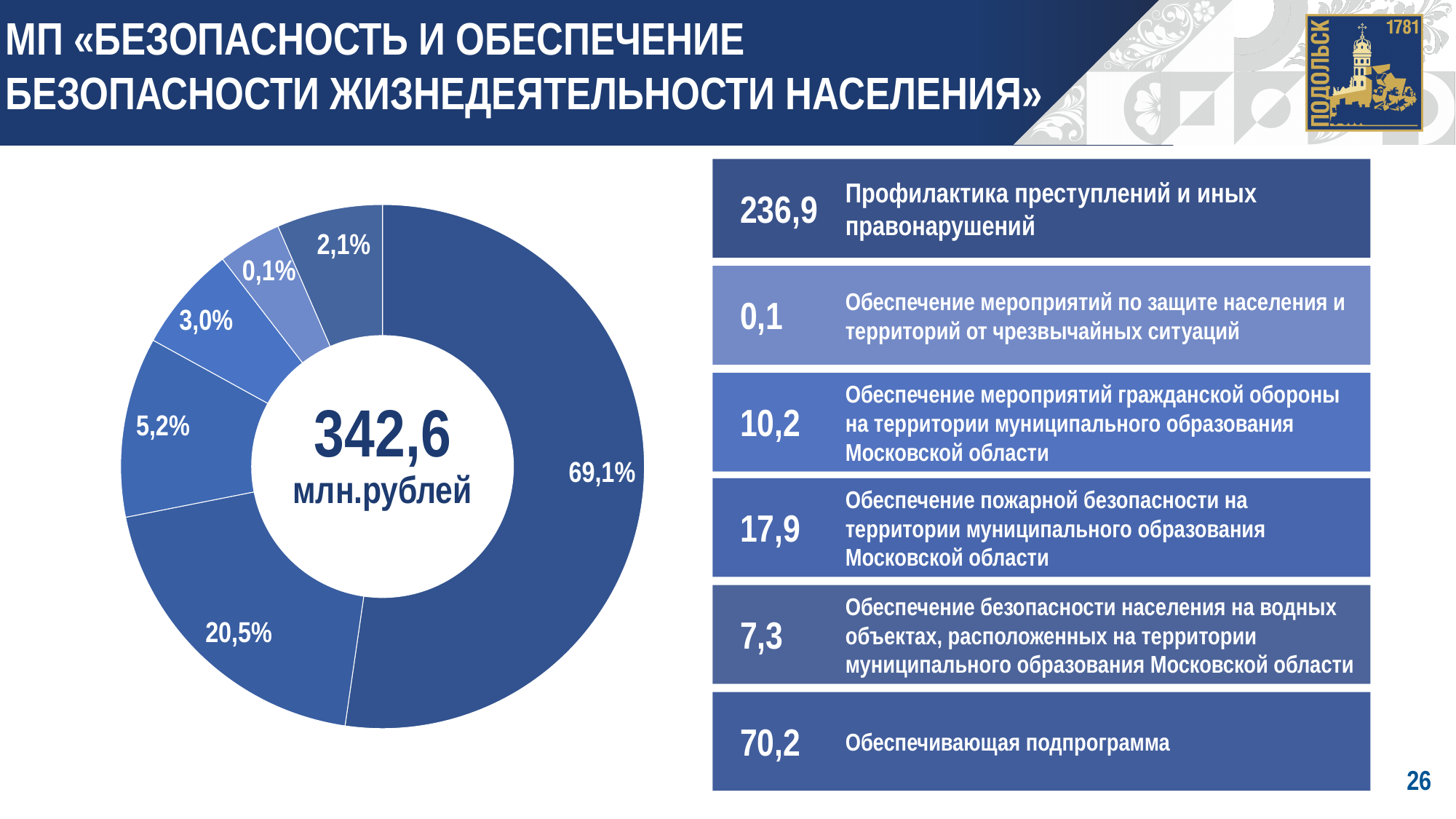
What is the second-largest share shown on the donut chart? 20,5% What total value is shown in the centre of the donut chart? 342,6 млн.рублей What amount is listed for «Профилактика преступлений и иных правонарушений»? 236,9 What amount is listed for «Обеспечивающая подпрограмма»? 70,2 What is the smallest share shown on the donut chart? 0,1% What type of chart is shown on the slide? pie chart (donut) Which is larger on the donut chart: the 5,2% slice or the 3,0% slice? 5,2% What amount is listed for «Обеспечение пожарной безопасности на территории муниципального образования Московской области»? 17,9 How many slices does the donut chart have? 6 What is the largest share shown on the donut chart? 69,1% What is the difference in percentage points between the 69,1% slice and the 20,5% slice? 48,6 Which listed subprogram has the smallest amount? Обеспечение мероприятий по защите населения и территорий от чрезвычайных ситуаций